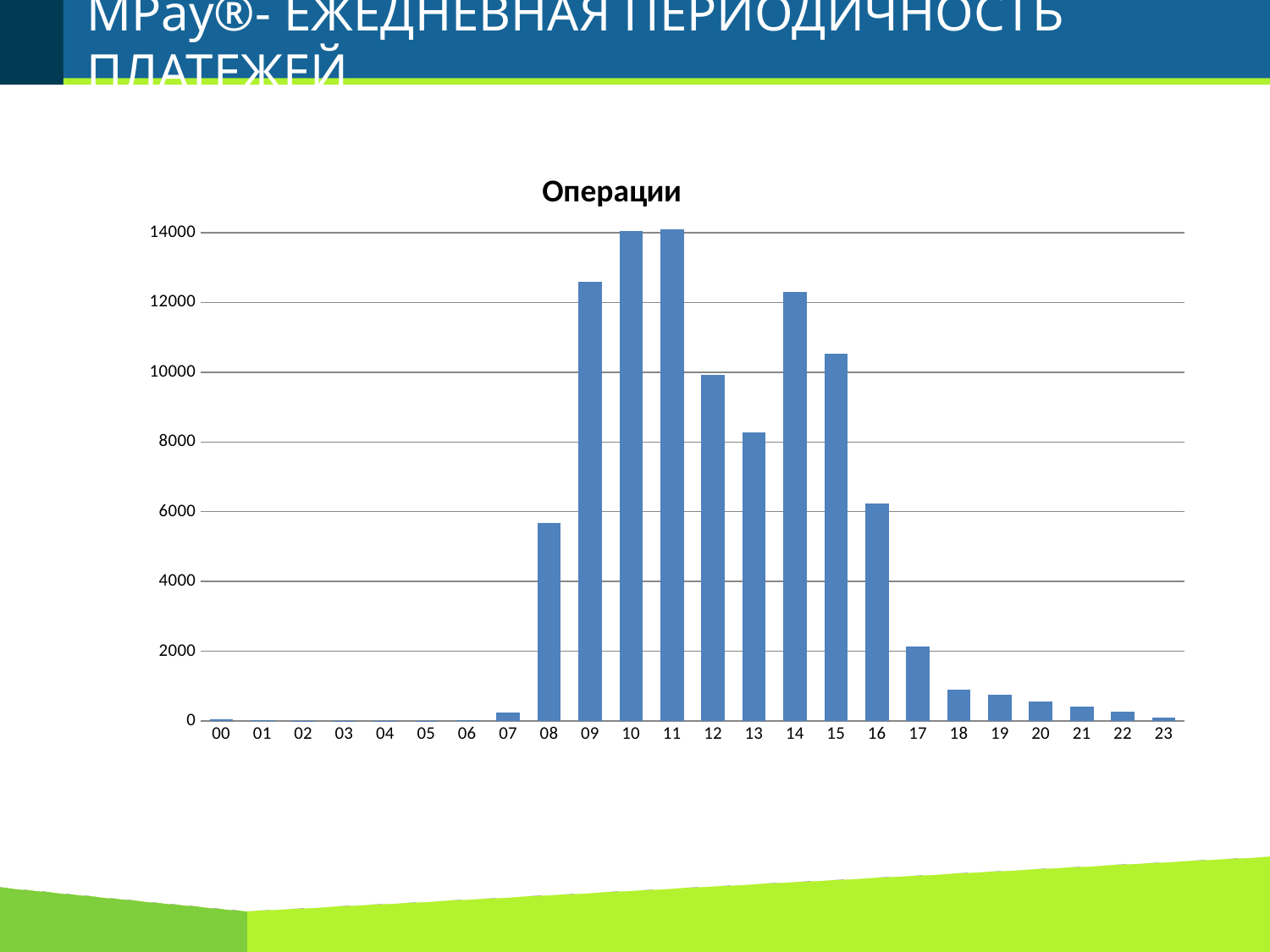
Which has a larger value, 09 or 15? 09 What is the title of the chart? Операции Which has a larger value, 16 or 17? 16 Which has a larger value, 12 or 13? 12 What kind of chart is shown on the slide? bar chart Is the value for 08 greater or less than 6000? less How many hour categories are shown on the x axis? 24 Do the values rise or fall from 17 to 23? fall Is the value for 13 greater or less than 8000? greater Is the value for 15 greater or less than 10000? greater